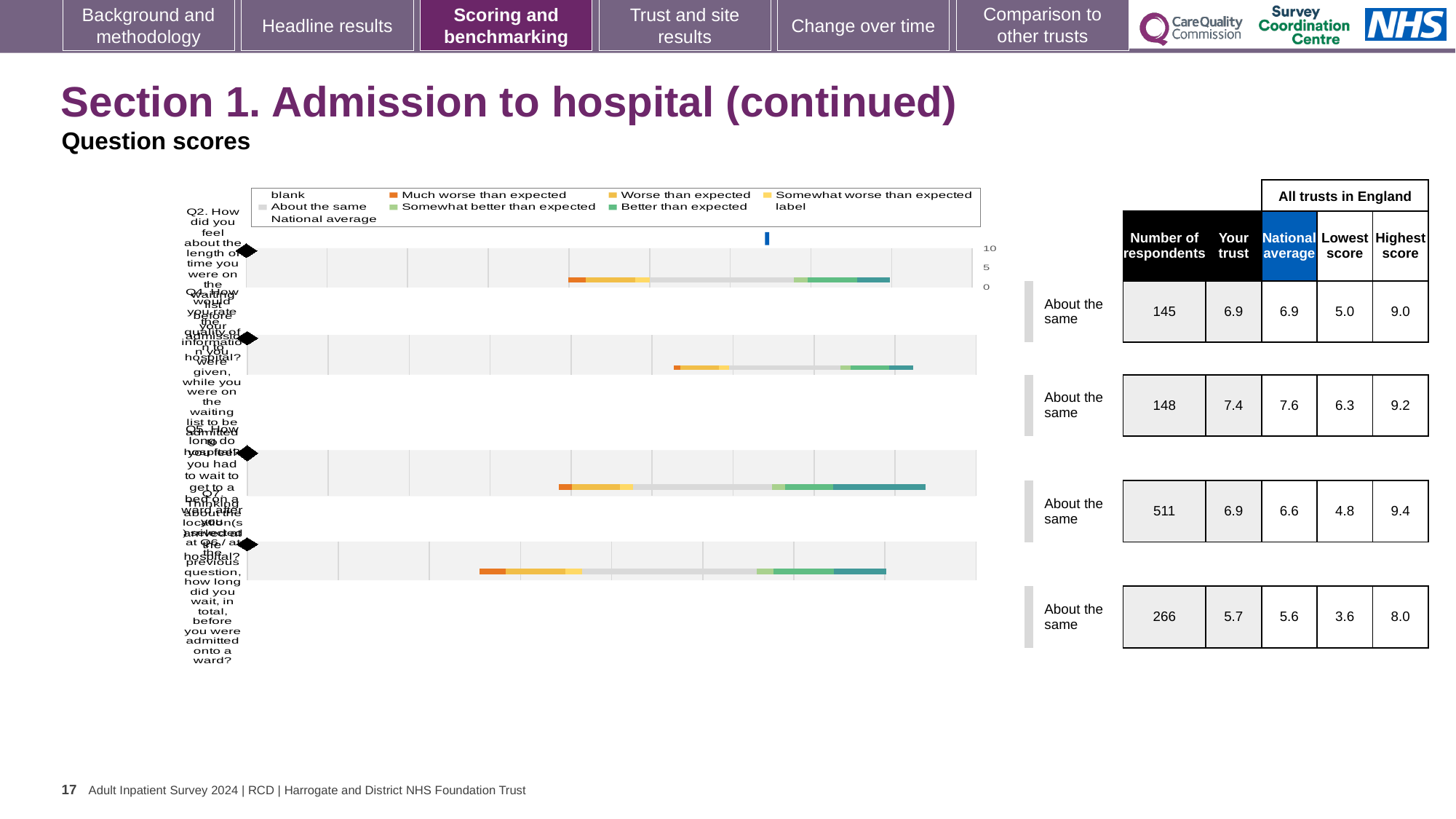
How many question bars are plotted in the chart? 4 In the table beside the chart, what is the national average for the fourth row? 5.6 In the table beside the chart, what is the difference between the highest score and the lowest score for the first row? 4.0 In the table beside the chart, what is the number of respondents for the first row? 145 What kind of chart is shown on the slide? bar chart What benchmark category is shown for each of the four questions on the slide? About the same Which row in the table beside the chart has the highest number of respondents? the third row (511) What is the highest value shown on the chart's axis? 10 In the table beside the chart, what is the 'Your trust' score for the second row? 7.4 In the table beside the chart, what is the lowest score for the third row? 4.8 For the second row of the table beside the chart, which is larger: the 'Your trust' score or the national average? National average